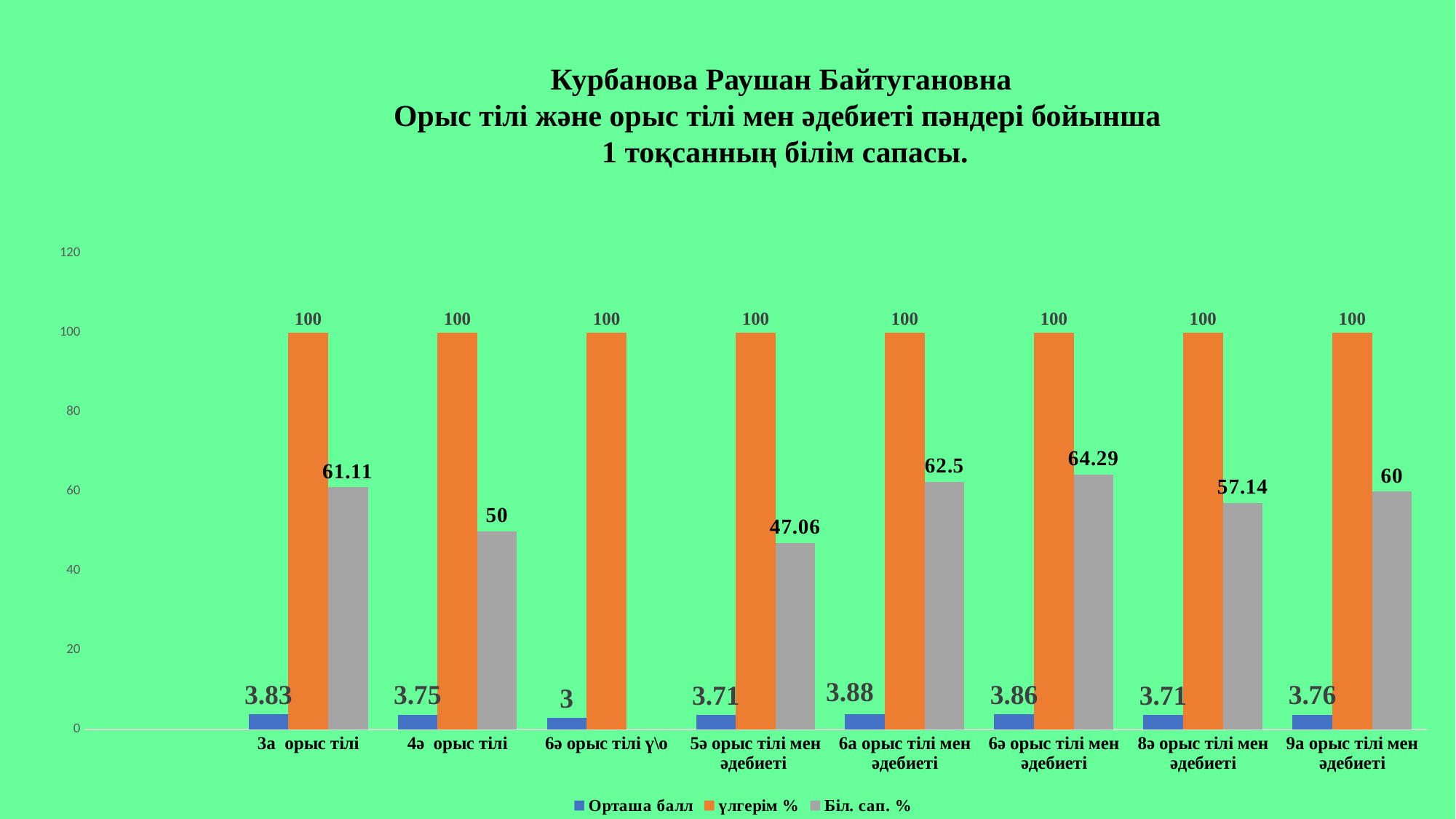
What kind of chart is shown on the slide? Bar chart Which category has the highest Біл. сап. % value? 6ә орыс тілі мен әдебиеті What is the үлгерім % value for 4ә орыс тілі? 100 What is the difference between the Біл. сап. % values for 6а орыс тілі мен әдебиеті and 5ә орыс тілі мен әдебиеті? 15.44 Which series is shown in orange in the legend? үлгерім % What is the Біл. сап. % value for 3а орыс тілі? 61.11 What is the Орташа балл value for 6а орыс тілі мен әдебиеті? 3.88 Which is larger, the Біл. сап. % value for 4ә орыс тілі or for 9а орыс тілі мен әдебиеті? 9а орыс тілі мен әдебиеті How many series does the legend list? 3 Which category has the lowest Орташа балл value? 6ә орыс тілі ү\о How many categories are shown on the x axis? 8 What is the Біл. сап. % value for 8ә орыс тілі мен әдебиеті? 57.14